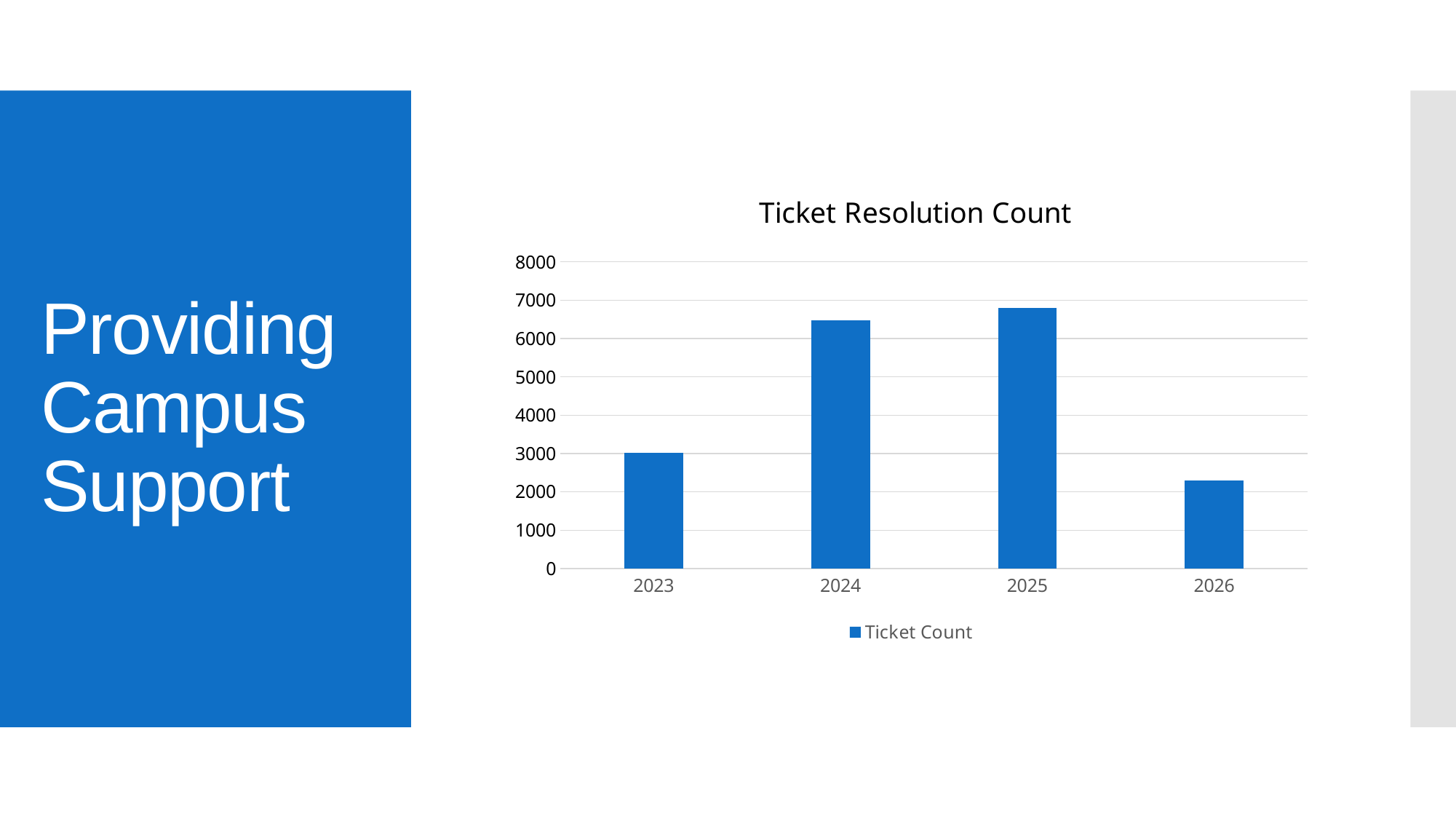
Which year has a larger ticket count, 2024 or 2026? 2024 Is the ticket count for 2026 greater or less than 2000? greater What is the title of the chart? Ticket Resolution Count Which year has the highest ticket count? 2025 How many series does the legend list? 1 Which year has the lowest ticket count? 2026 How many years are shown on the x axis of the chart? 4 Is the ticket count for 2025 greater or less than 7000? less Does the ticket count rise or fall from 2025 to 2026? fall What type of chart is shown on the slide? bar chart Is the ticket count for 2024 greater or less than 6000? greater